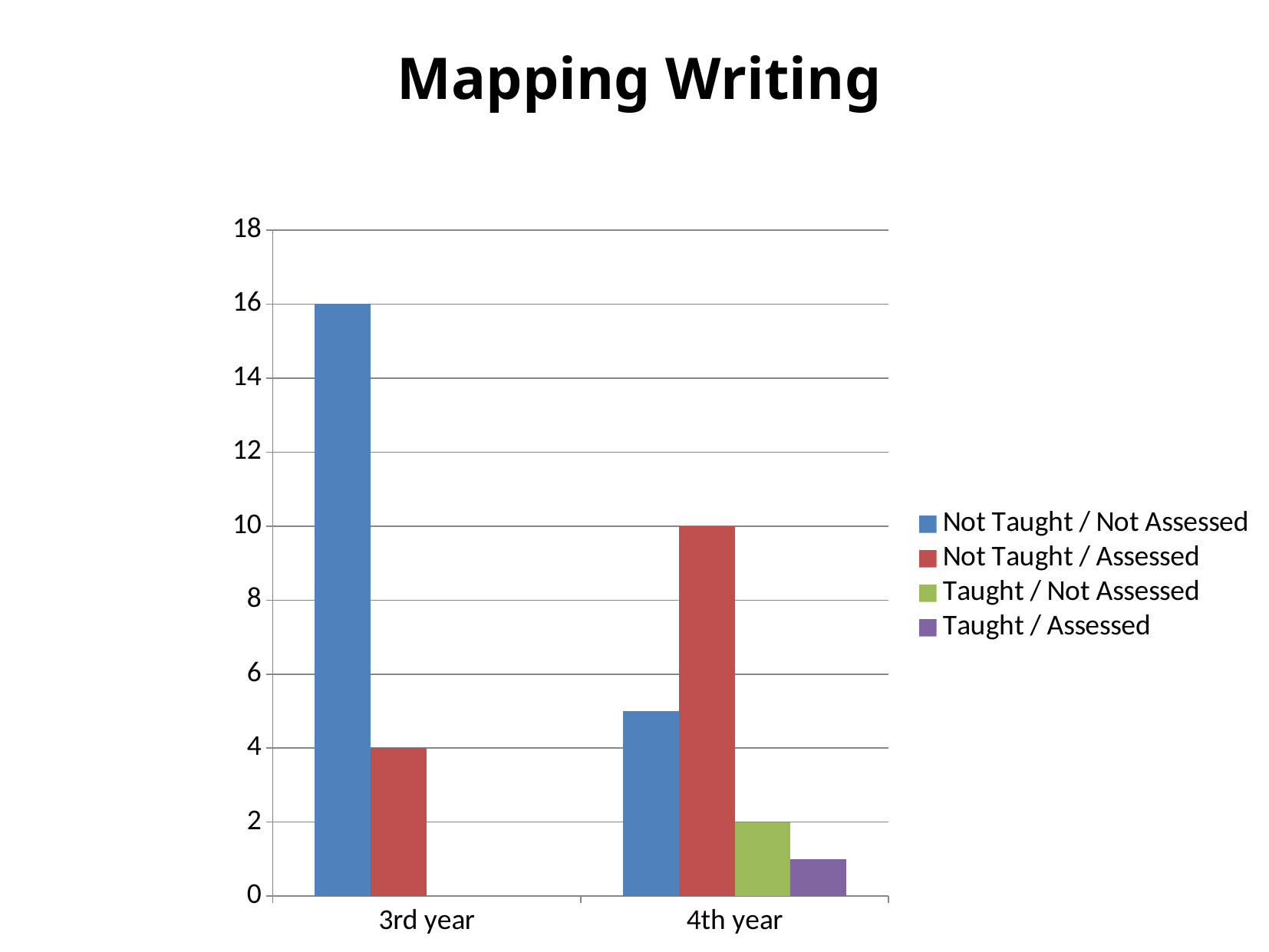
Which is larger: Not Taught / Not Assessed in 3rd year or Not Taught / Assessed in 4th year? Not Taught / Not Assessed in 3rd year What is the title of the chart? Mapping Writing Is the value for Not Taught / Not Assessed in 4th year greater or less than 6? less What is the difference between Not Taught / Not Assessed and Not Taught / Assessed in 3rd year? 12 How many categories are shown on the x axis? 2 What is the value for Not Taught / Not Assessed in 3rd year? 16 Which series has the highest value in 4th year? Not Taught / Assessed How many series does the legend list? 4 What is the value for Not Taught / Assessed in 3rd year? 4 What kind of chart is shown on the slide? bar chart What is the value for Taught / Not Assessed in 4th year? 2 What is the value for Not Taught / Assessed in 4th year? 10